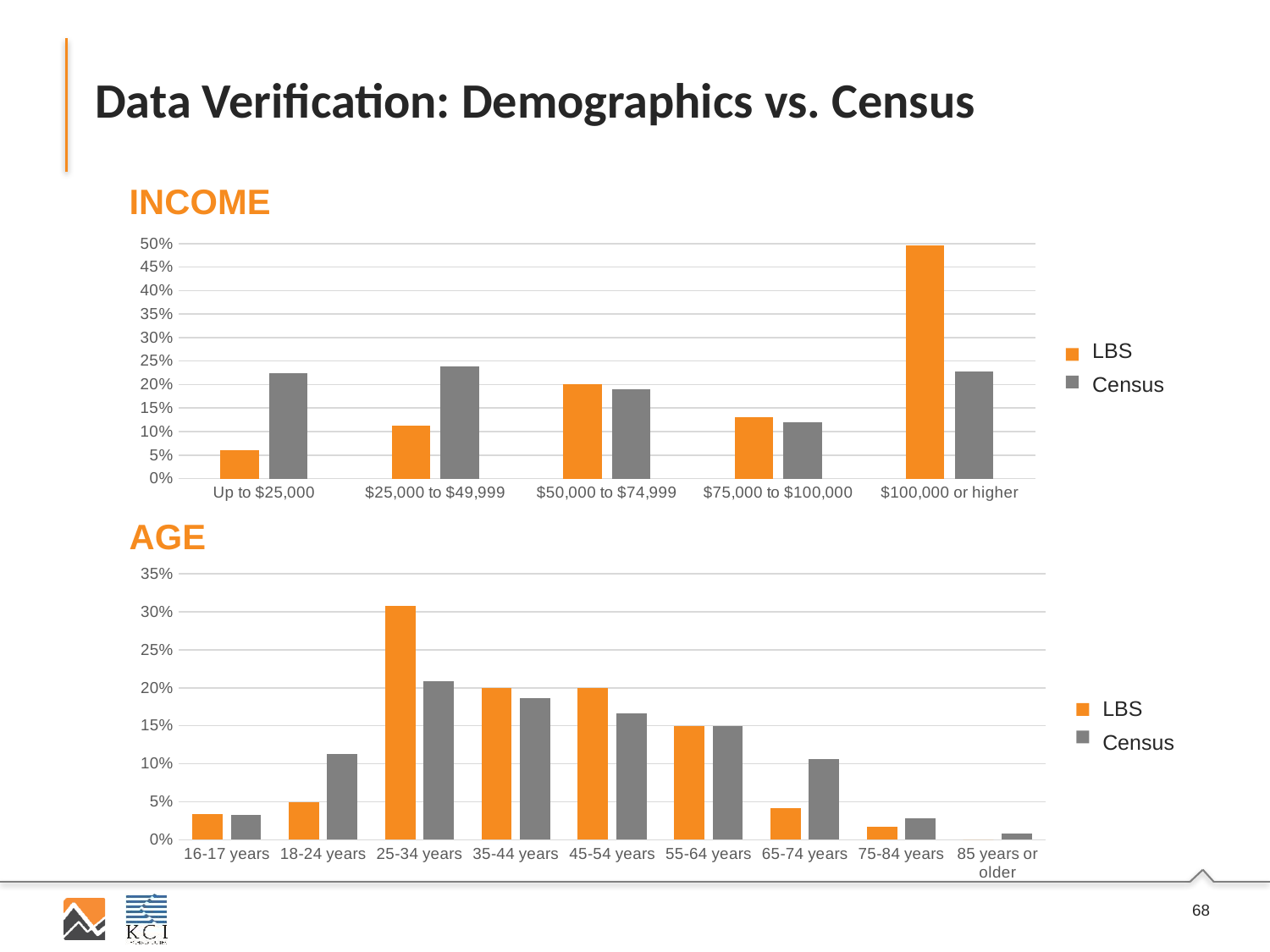
On the INCOME chart, how many income categories are shown on the x axis? 5 On the INCOME chart, is the LBS value for Up to $25,000 greater or less than 10%? less On the AGE chart, which age group has the highest LBS value? 25-34 years What kind of chart is the INCOME chart? bar chart On the INCOME chart, which income category has the highest LBS value? $100,000 or higher On the AGE chart, how many series does the legend list? 2 On the INCOME chart, is the Census value for $25,000 to $49,999 greater or less than 20%? greater On the AGE chart, how many age groups are shown on the x axis? 9 On the INCOME chart, for the Up to $25,000 category, which is larger, LBS or Census? Census On the AGE chart, is the LBS value for 25-34 years greater or less than 25%? greater On the AGE chart, for the 65-74 years group, which is larger, LBS or Census? Census